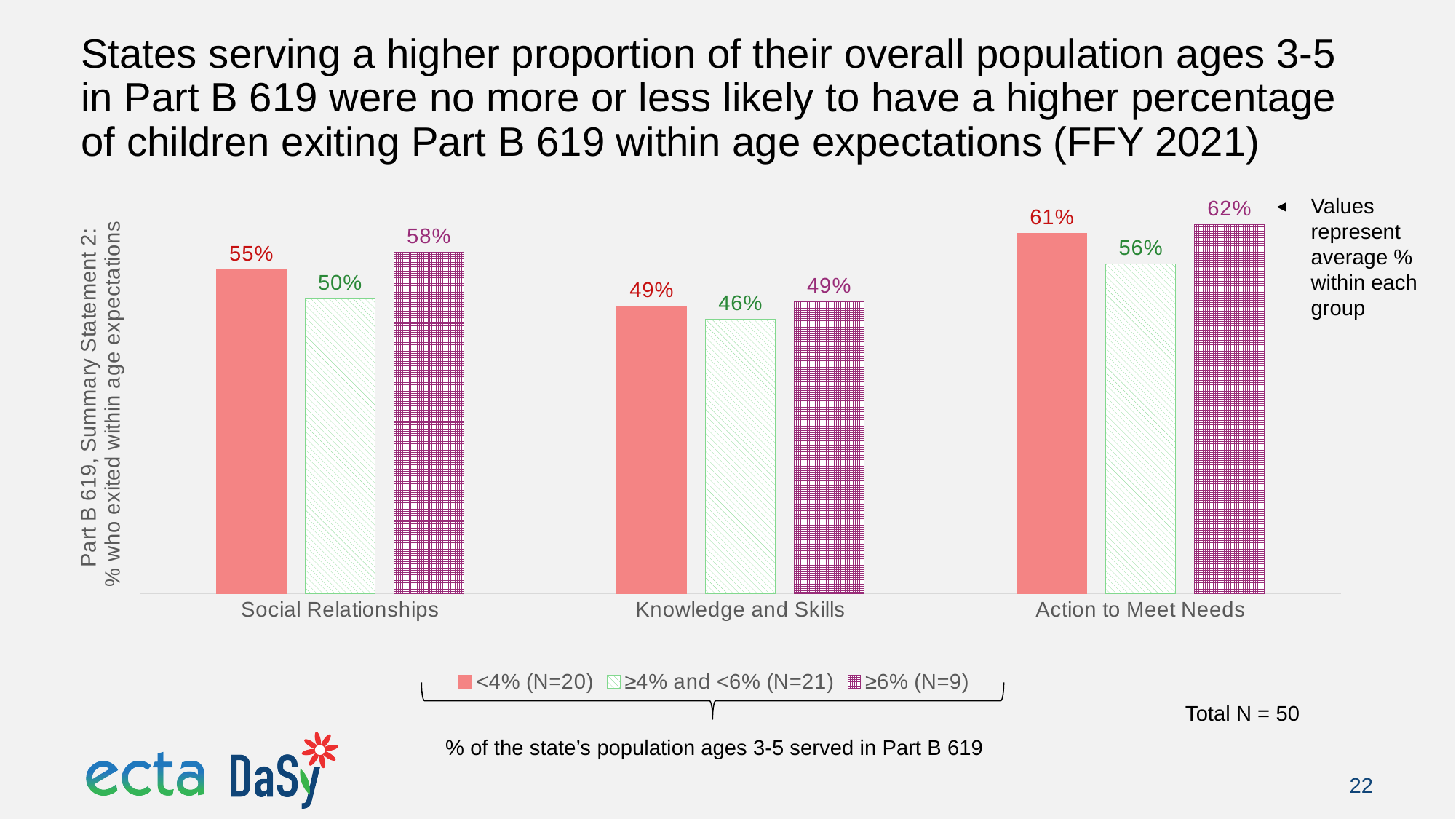
What is the value for the <4% (N=20) group in the Social Relationships category? 55% Which group has the lowest value in the Knowledge and Skills category? ≥4% and <6% (N=21) What kind of chart is shown on the slide? Bar chart What is the value for the ≥4% and <6% (N=21) group in the Knowledge and Skills category? 46% How many series does the legend list? 3 What is the difference between the ≥6% (N=9) and <4% (N=20) values in the Social Relationships category? 3% What does the legend say the three groups represent? % of the state's population ages 3-5 served in Part B 619 Which group has the highest value in the Action to Meet Needs category? ≥6% (N=9) How many categories are shown on the x axis? 3 What is the value for the ≥6% (N=9) group in the Action to Meet Needs category? 62% Which is larger: the <4% (N=20) value for Action to Meet Needs or the <4% (N=20) value for Knowledge and Skills? Action to Meet Needs What is the total N stated on the slide? 50